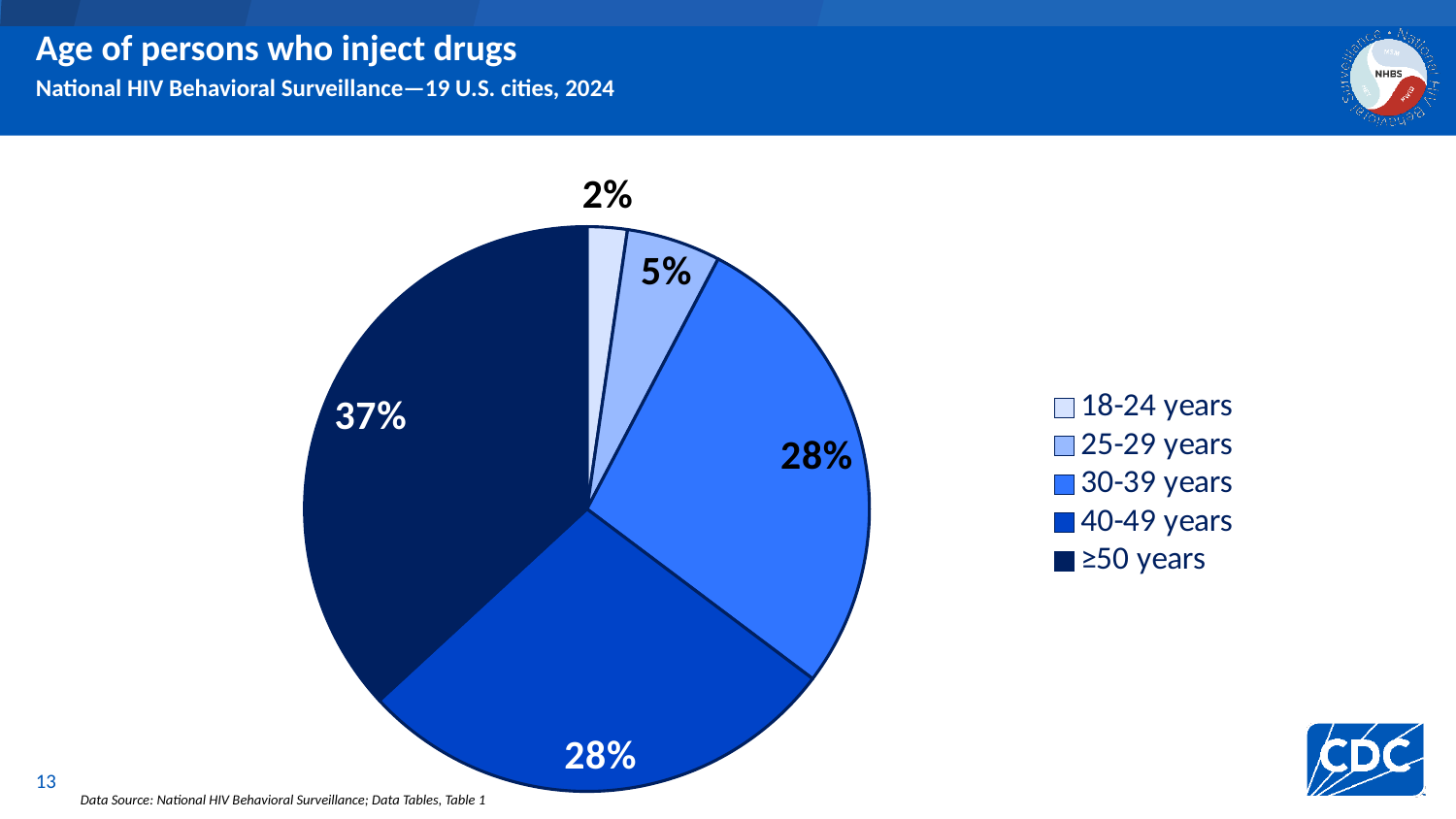
Which is larger, the share for 25-29 years or the share for 18-24 years? 25-29 years What is the difference in percentage points between the ≥50 years group and the 25-29 years group? 32 What percentage of persons who inject drugs are aged ≥50 years? 37% Which age group has the largest share of the pie? ≥50 years What percentage of persons who inject drugs are aged 18-24 years? 2% What percentage of persons who inject drugs are aged 25-29 years? 5% What type of chart is shown on the slide? Pie chart What percentage of persons who inject drugs are aged 40-49 years? 28% How many age groups are shown in the pie chart? 5 What percentage of persons who inject drugs are aged 30-39 years? 28% Which age group has the smallest share of the pie? 18-24 years What is the title of the chart? Age of persons who inject drugs